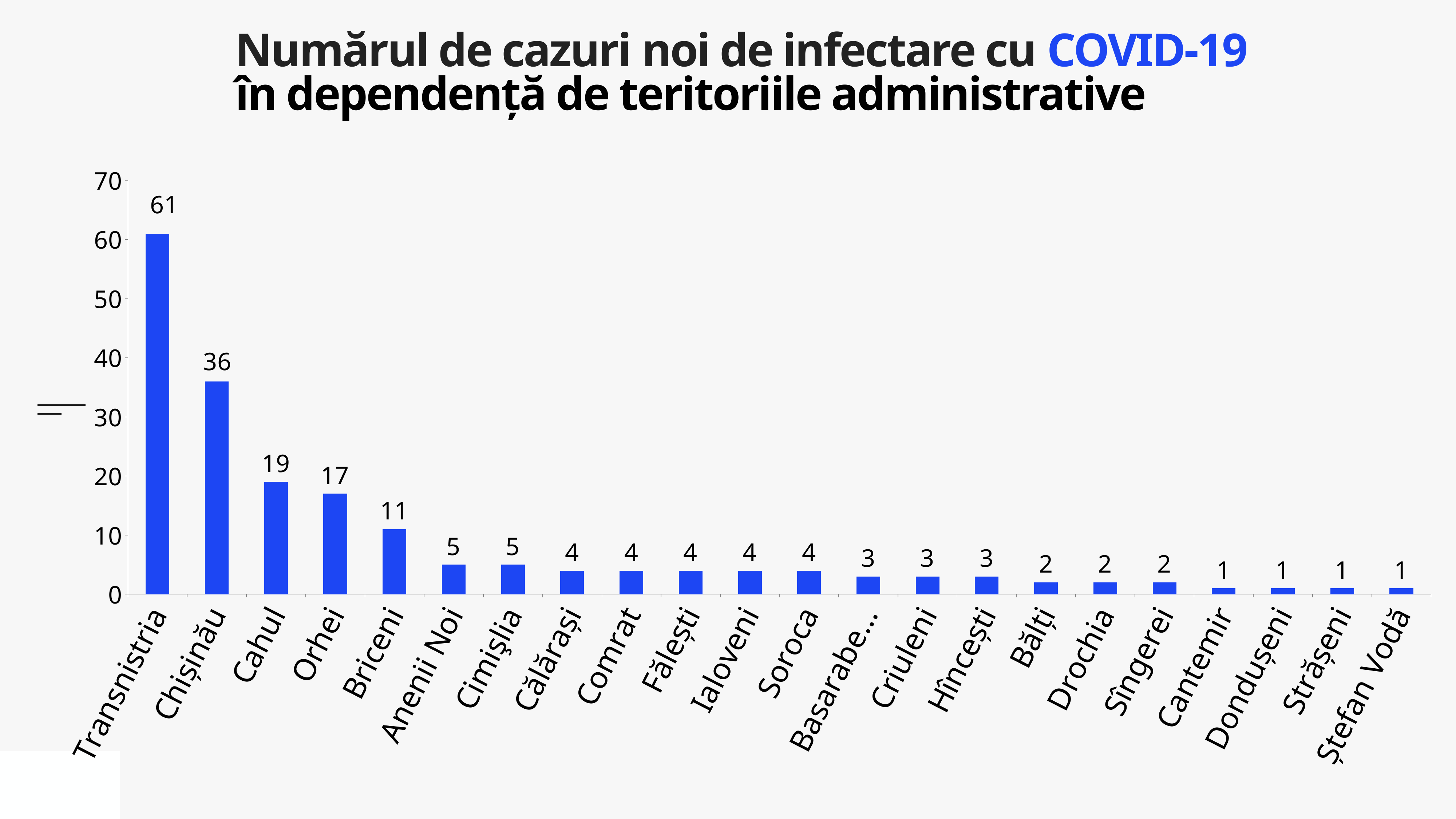
What is the value for Hîncești? 3 Which has a larger value, Cahul or Briceni? Cahul Which has a larger value, Soroca or Bălți? Soroca Which territory has the highest number of new cases? Transnistria What is the difference between the values for Transnistria and Chișinău? 25 What is the value for Briceni? 11 How many territories are shown on the x axis? 22 What is the value for Chișinău? 36 What is the value for Orhei? 17 Do the values rise or fall from left to right along the x axis? fall What kind of chart is shown on the slide? bar chart What is the difference between the values for Cahul and Orhei? 2